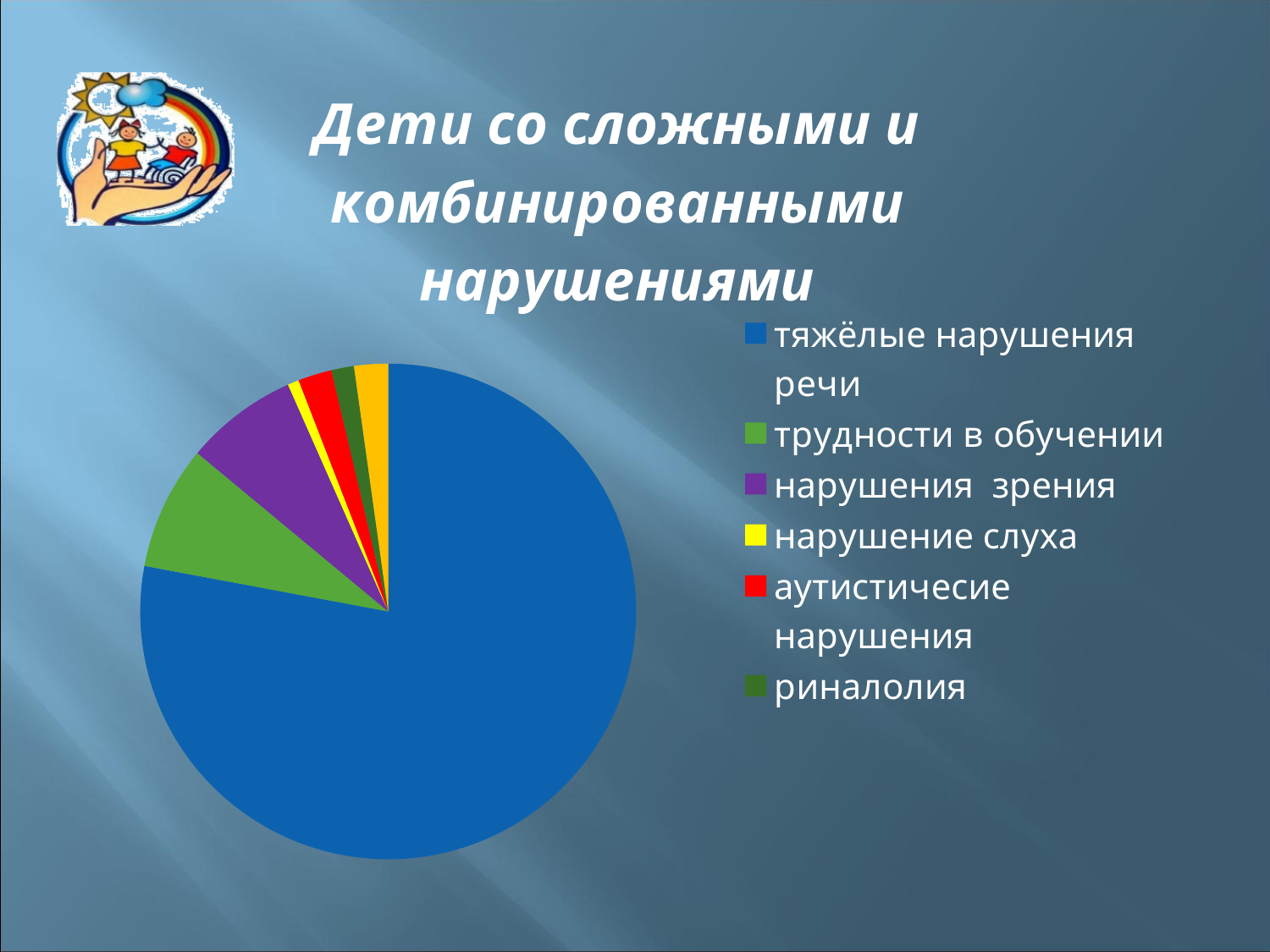
Which slice is larger: нарушения зрения or аутистичесие нарушения? нарушения зрения How many entries does the chart legend list? 6 Which slice is larger: тяжёлые нарушения речи or трудности в обучении? тяжёлые нарушения речи What kind of chart is shown on the slide? pie chart What colour is used for the category трудности в обучении in the legend? green Does the slice for тяжёлые нарушения речи take up more or less than half of the pie? more What is the title of the slide containing the chart? Дети со сложными и комбинированными нарушениями Which category has the largest slice of the pie? тяжёлые нарушения речи